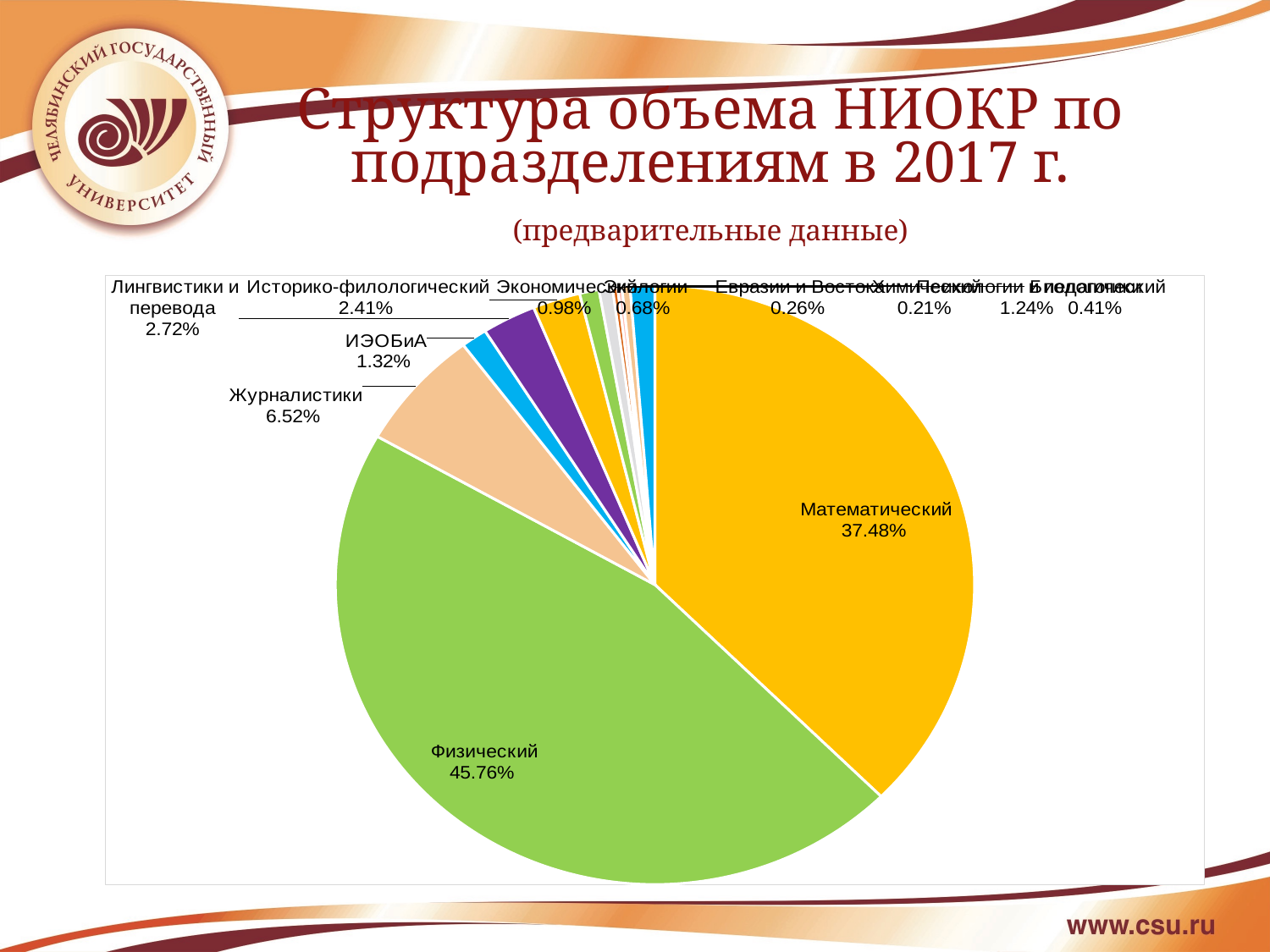
What share of the pie does Математический have? 37.48% What kind of chart is shown on the slide? pie chart What share of the pie does Физический have? 45.76% What is the value shown for Журналистики? 6.52% What is the difference in percentage points between Физический and Математический? 8.28% Which division has the largest slice of the pie? Физический What is the title of the chart on the slide? Структура объема НИОКР по подразделениям в 2017 г. What is the difference in percentage points between Журналистики and Лингвистики и перевода? 3.80% What is the value shown for Лингвистики и перевода? 2.72% Which is larger, the slice for Журналистики or the slice for ИЭОБиА? Журналистики What is the value shown for Историко-филологический? 2.41% What is the value shown for ИЭОБиА? 1.32%